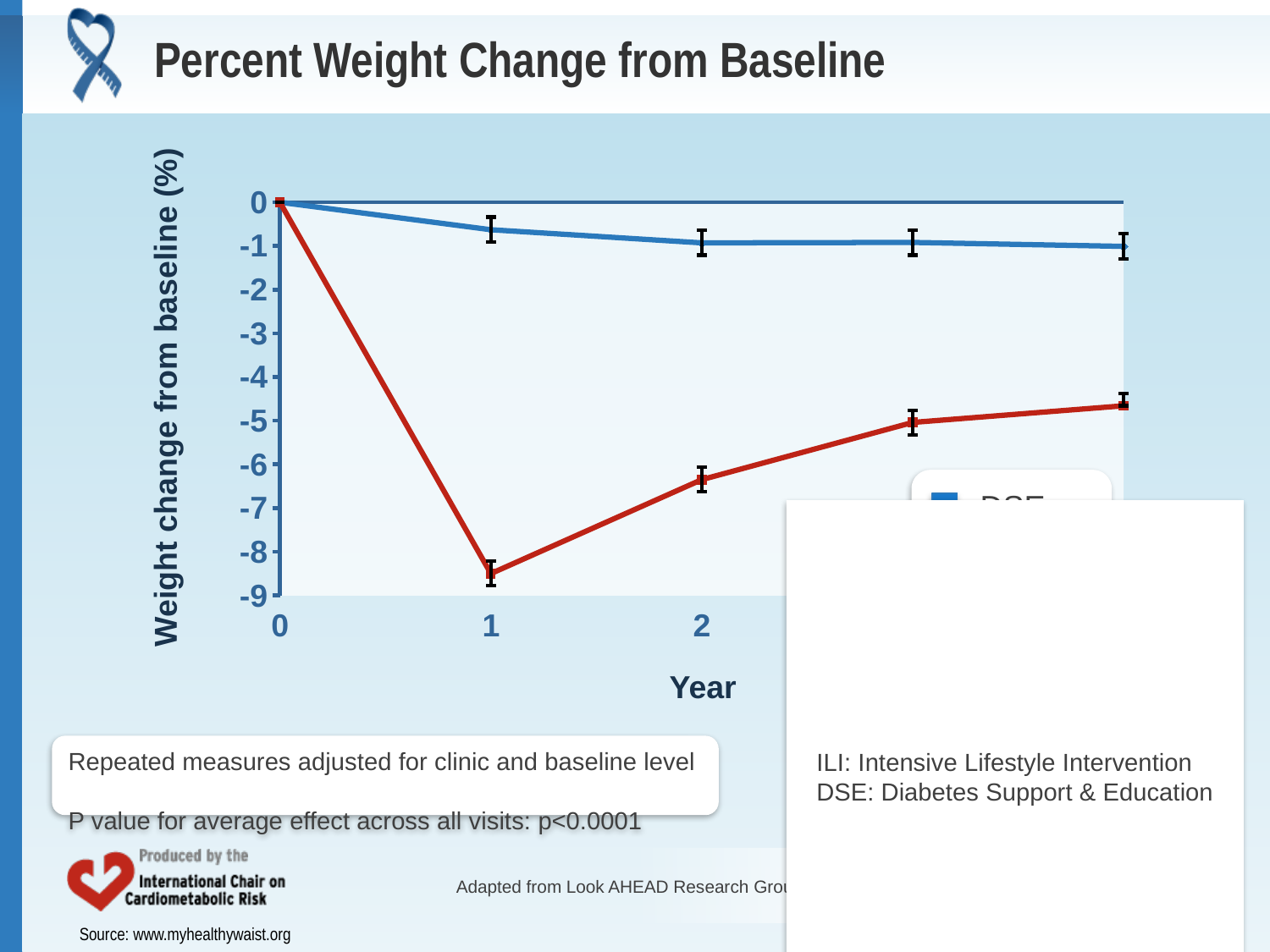
Does the red line rise or fall between year 1 and year 2? rise What kind of chart is shown on the slide? line chart Is the value of the red line at year 1 greater or less than -8? less At year 1, which line has the lower value, the red line or the blue line? the red line What is the value of the blue line at year 0? 0 Is the value of the blue line at year 1 greater or less than -1? greater Is the value of the red line at year 2 greater or less than -7? greater At which year does the red line reach its lowest value? 1 What is the title of the chart? Percent Weight Change from Baseline What is the label of the y axis? Weight change from baseline (%) What is the value of the red line at year 0? 0 Does the blue line rise or fall between year 0 and year 1? fall